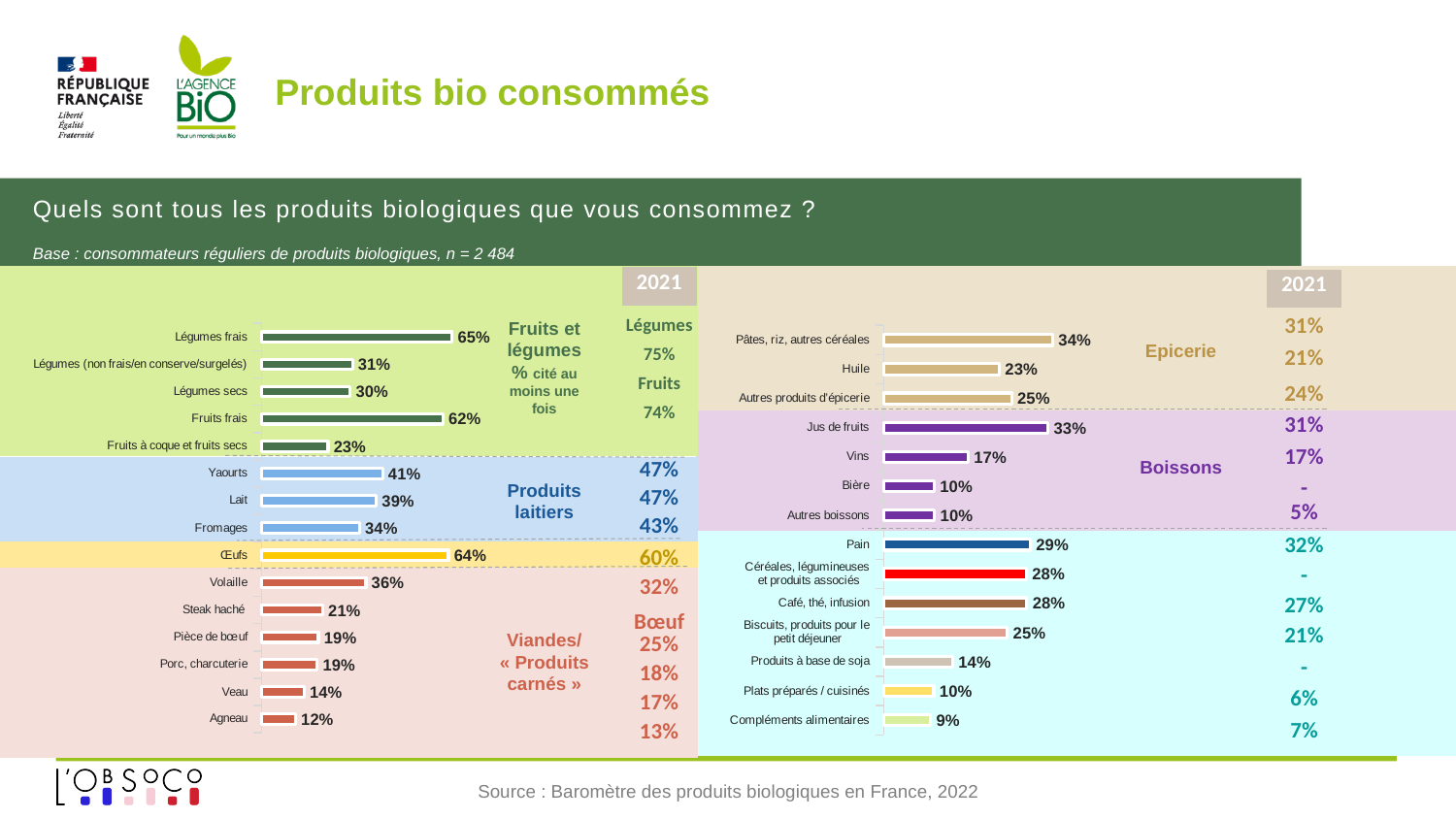
On the right-hand chart, which category has the lowest value? Compléments alimentaires On the right-hand chart, which is larger, the value for Huile or the value for Autres produits d'épicerie? Autres produits d'épicerie What type of chart is used on the slide? Bar chart On the right-hand chart, which category has the highest value? Pâtes, riz, autres céréales On the left-hand chart, how many categories are plotted? 15 On the right-hand chart, what is the value for Compléments alimentaires? 9% On the left-hand chart, what is the difference between the values for Légumes frais and Fruits frais? 3% On the right-hand chart, what is the value for Jus de fruits? 33% On the left-hand chart, what is the value for Légumes frais? 65% On the left-hand chart, which category has the lowest value? Agneau On the left-hand chart, which category has the highest value? Légumes frais On the left-hand chart, what is the value for Œufs? 64%